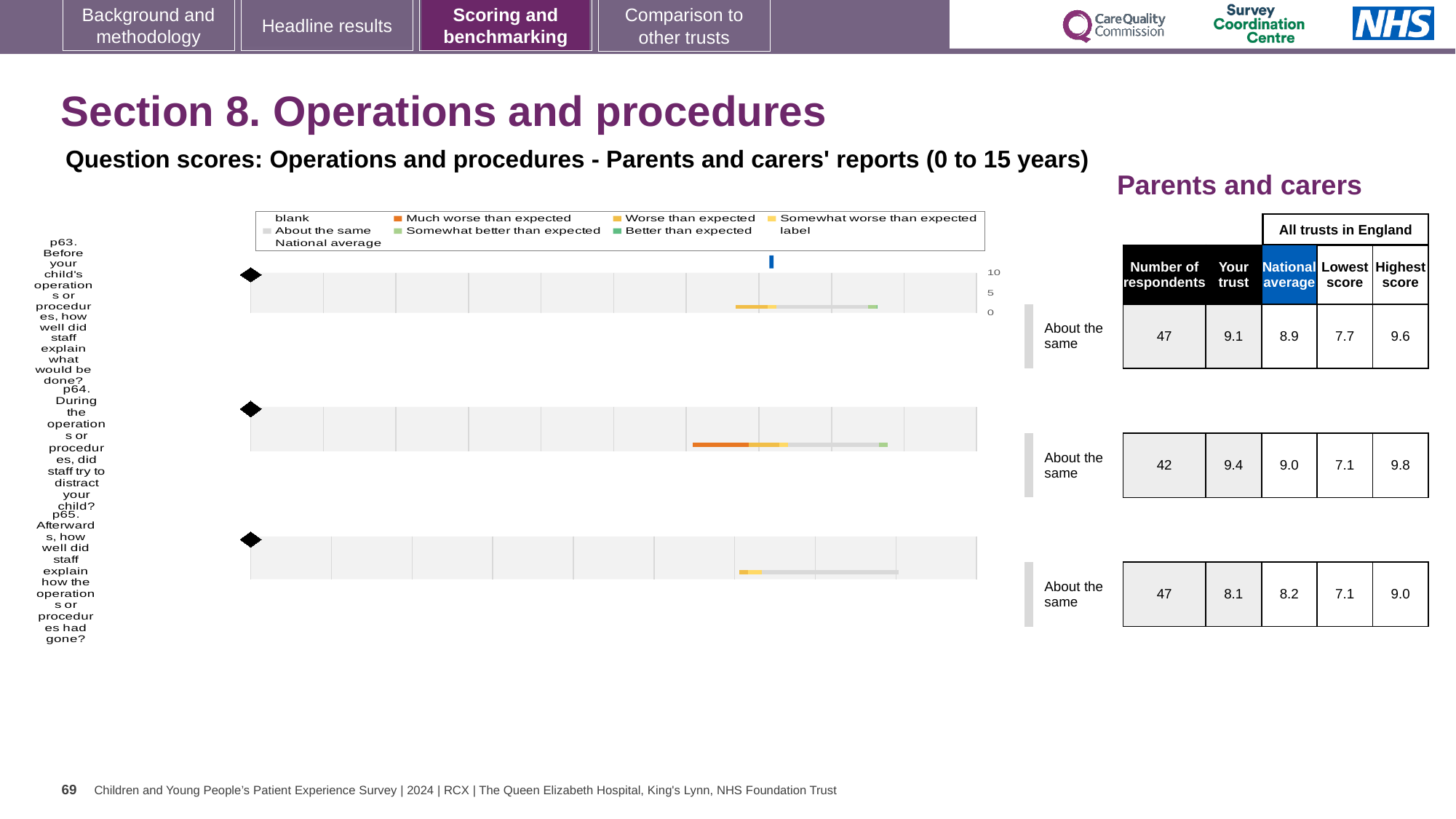
How many question rows (charts) are shown on the slide for Operations and procedures? 3 What is the highest score across all trusts in England for p65 (Afterwards, how well did staff explain how the operations or procedures had gone?)? 9.0 What benchmark category is shown for all three questions? About the same Is the 'Your trust' score for p65 higher or lower than the national average? lower What is the difference between the 'Your trust' score and the national average for p63? 0.2 How many respondents answered p64? 42 What is the national average for p64 (During the operations or procedures, did staff try to distract your child?)? 9.0 What is the 'Your trust' score for p63 (Before your child's operations or procedures, how well did staff explain what would be done?)? 9.1 How many entries does the legend above the charts list? 9 Which of the three questions has the lowest 'Your trust' score? p65 What kind of chart is used to show the benchmarking results for each question? bar chart Which of the three questions has the highest 'Your trust' score? p64